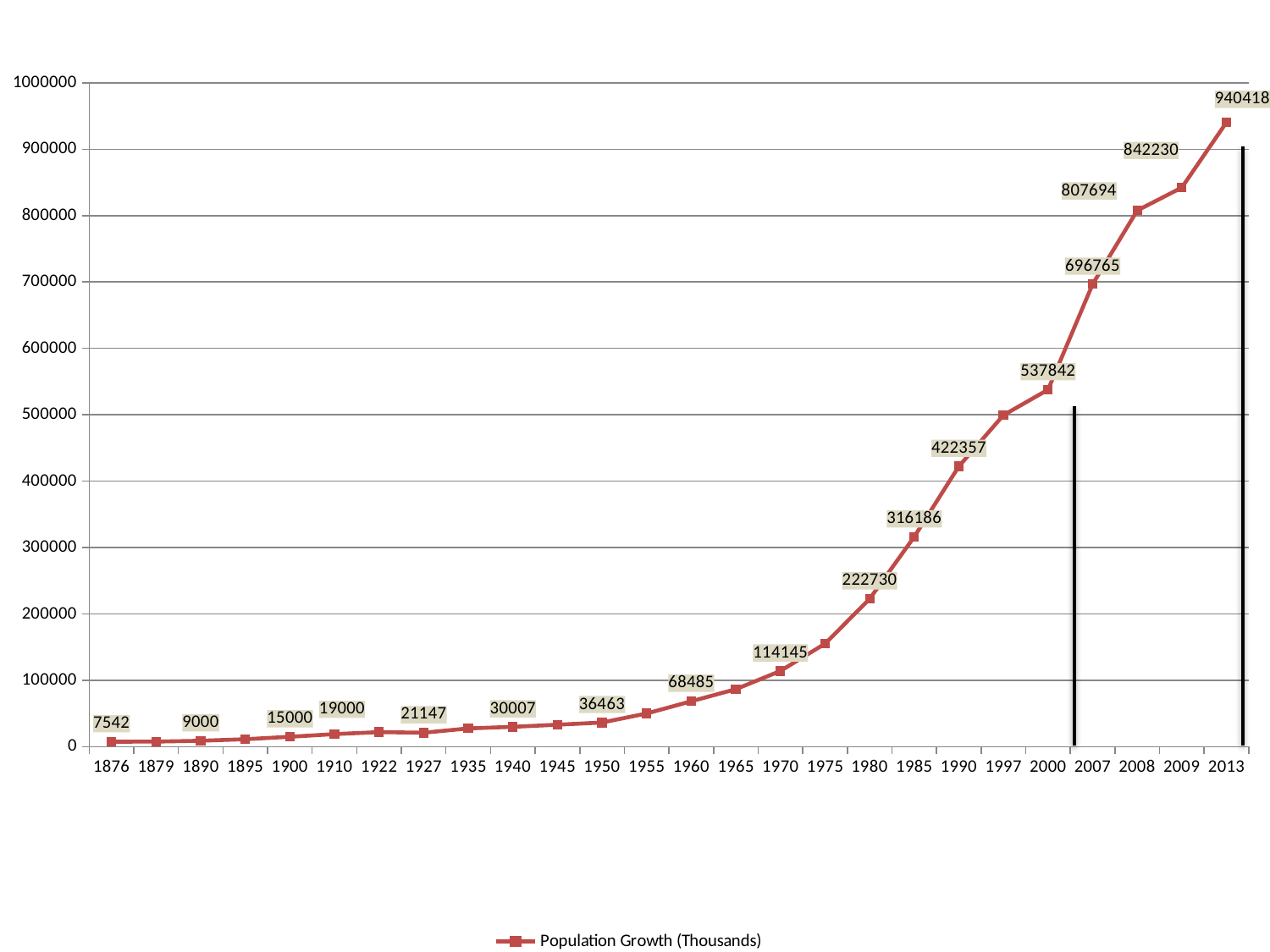
Which is larger, the value for 1990 or the value for 1985? 1990 How many years are shown on the x axis? 26 Which year has the highest value? 2013 How many series does the legend list? 1 What is the value for 2013? 940418 What is the value for 2000? 537842 Is the value for 1975 greater or less than 100000? greater What is the value for 1970? 114145 What kind of chart is this? line chart What is the difference between the values for 2009 and 2008? 34536 Which year has the lowest value? 1876